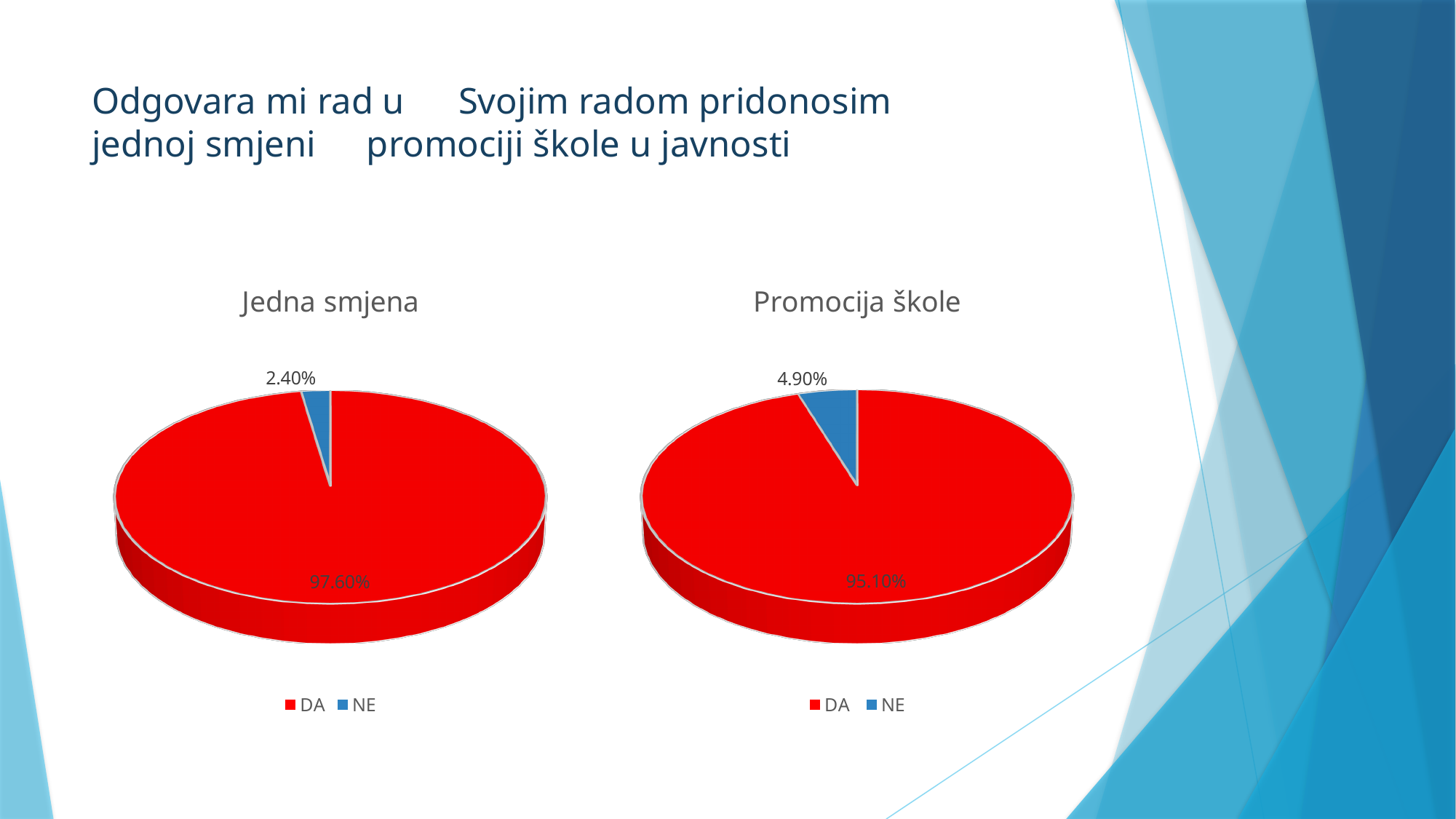
In the 'Jedna smjena' chart, what is the difference between the DA and NE values? 95.20% Which chart has the larger NE value, 'Jedna smjena' or 'Promocija škole'? Promocija škole In the 'Promocija škole' chart, which category has the smallest slice? NE In the 'Promocija škole' chart, what is the difference between the DA and NE values? 90.20% In the 'Jedna smjena' chart, what is the value for DA? 97.60% How many categories does the 'Promocija škole' chart show? 2 In the 'Promocija škole' chart, what is the value for NE? 4.90% In the 'Jedna smjena' chart, what is the value for NE? 2.40% In the 'Promocija škole' chart, what is the value for DA? 95.10% In the 'Jedna smjena' chart, what colour is the DA slice? Red In the 'Jedna smjena' chart, which category has the largest slice? DA What kind of chart is the 'Jedna smjena' chart? Pie chart